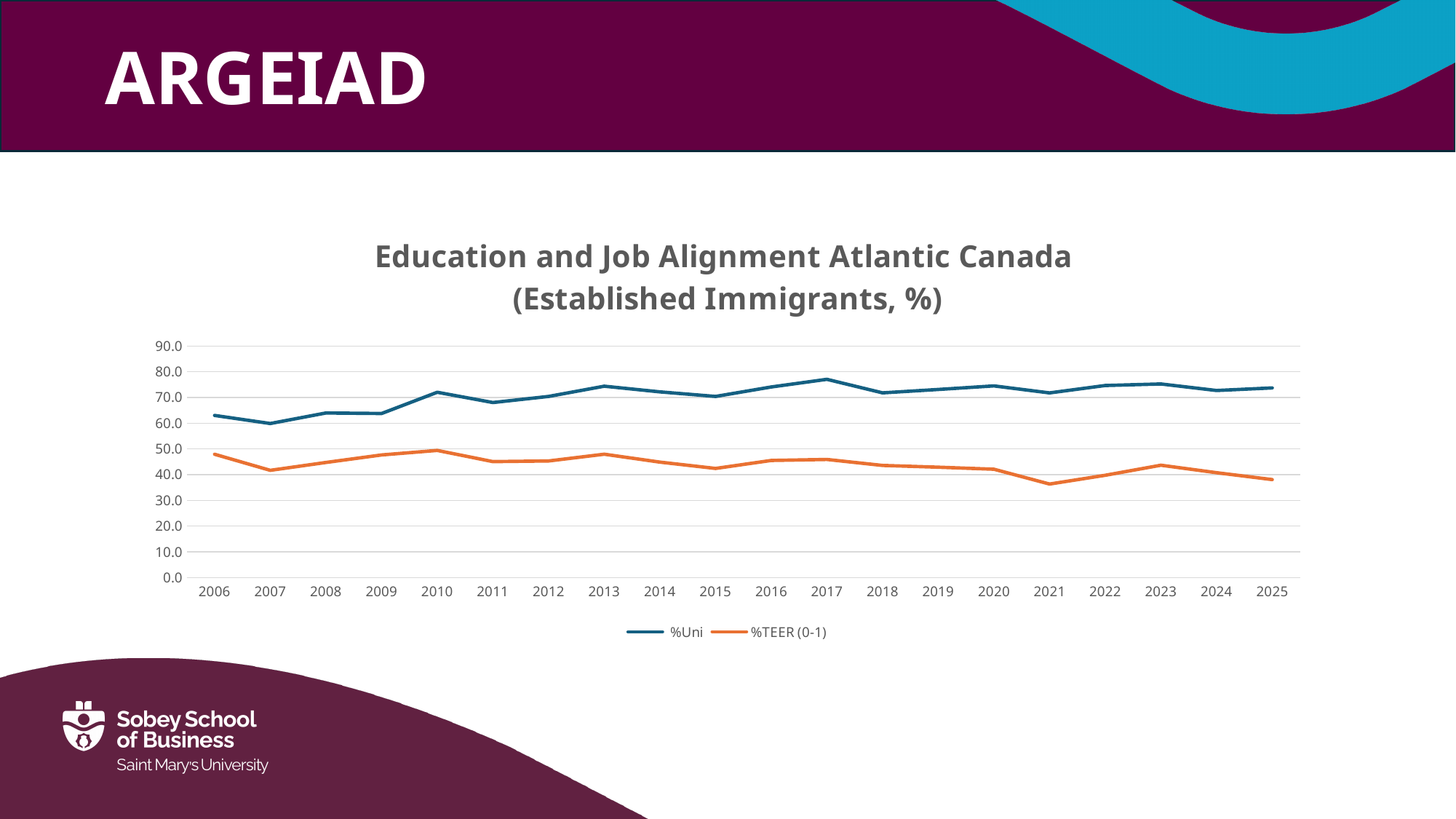
In which year is the %Uni series at its highest? 2017 Which series is drawn in orange? %TEER (0-1) Does the %Uni series overall rise or fall from 2006 to 2025? rise In which year is the %TEER (0-1) series at its lowest? 2021 Is the %TEER (0-1) value for 2021 greater or less than 40? less How many series does the legend list? 2 Which series has the larger value in 2015, %Uni or %TEER (0-1)? %Uni In which year is the %Uni series at its lowest? 2007 What is the title of the chart? Education and Job Alignment Atlantic Canada (Established Immigrants, %) How many years are plotted along the x axis? 20 Is the %Uni value for 2007 greater or less than 70? less What kind of chart is shown on the slide? line chart